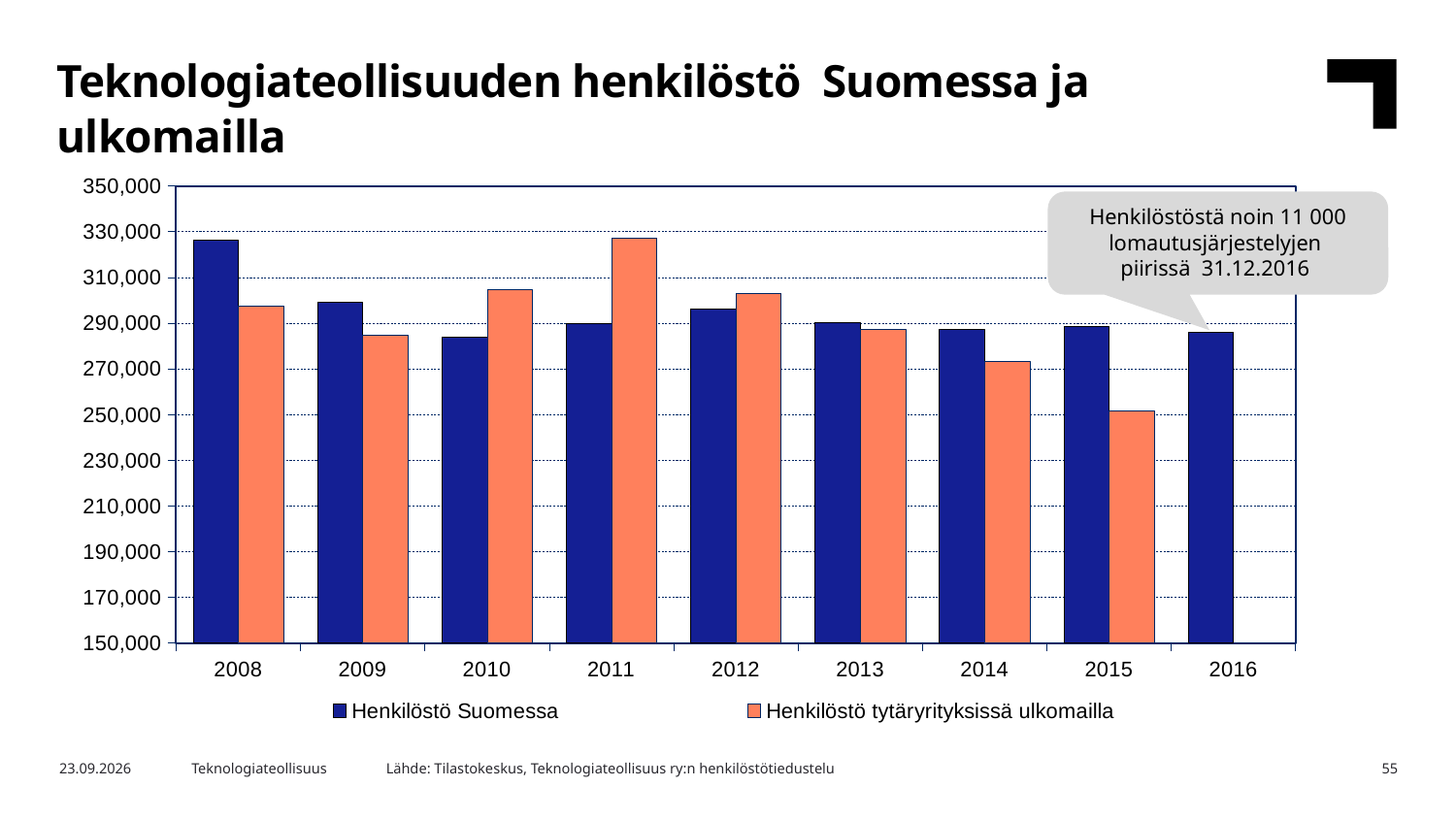
Which year has a bar for only one of the two series? 2016 Is the value for Henkilöstö tytäryrityksissä ulkomailla in 2015 greater or less than 270,000? less In which year is the value for Henkilöstö tytäryrityksissä ulkomailla highest? 2011 How many series does the legend list? 2 Does the value for Henkilöstö Suomessa rise or fall from 2008 to 2016? fall In which year is the value for Henkilöstö Suomessa highest? 2008 What kind of chart is shown on the slide? bar chart In 2015, which is larger: Henkilöstö Suomessa or Henkilöstö tytäryrityksissä ulkomailla? Henkilöstö Suomessa In which year is the value for Henkilöstö tytäryrityksissä ulkomailla lowest? 2015 How many years are shown on the x axis? 9 In 2011, which is larger: Henkilöstö Suomessa or Henkilöstö tytäryrityksissä ulkomailla? Henkilöstö tytäryrityksissä ulkomailla Is the value for Henkilöstö Suomessa in 2008 greater or less than 310,000? greater